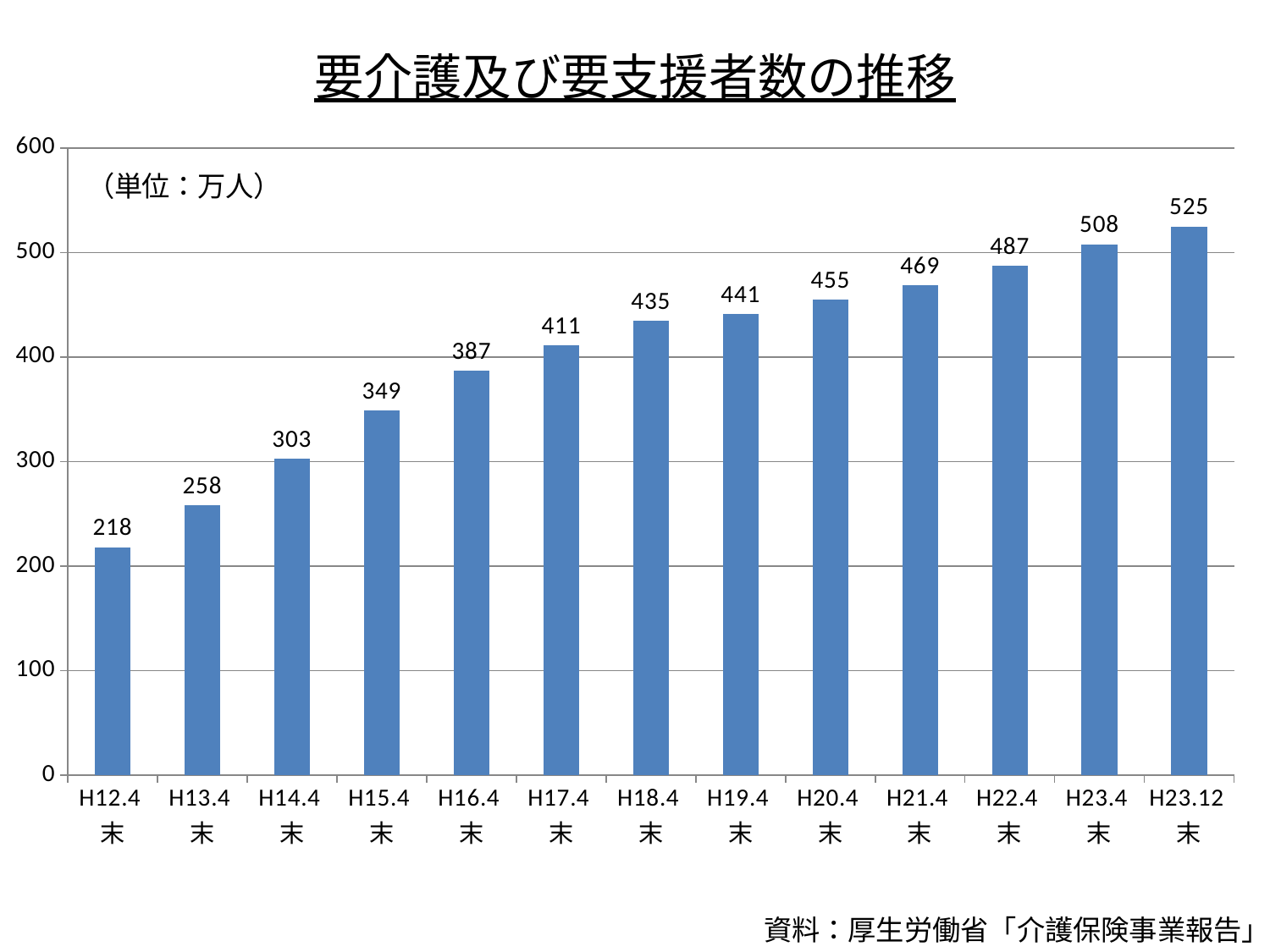
What is the difference between the values for H23.12末 and H12.4末? 307 Do the values rise or fall from left to right along the x axis? Rise What is the value for H12.4末? 218 What is the difference between the values for H15.4末 and H14.4末? 46 What kind of chart is this? Bar chart What is the value for H18.4末? 435 Which category has the highest value? H23.12末 Which category has the lowest value? H12.4末 How many categories are shown on the x axis? 13 Which is larger, the value for H16.4末 or the value for H19.4末? H19.4末 What is the value for H23.12末? 525 What is the title of the chart? 要介護及び要支援者数の推移